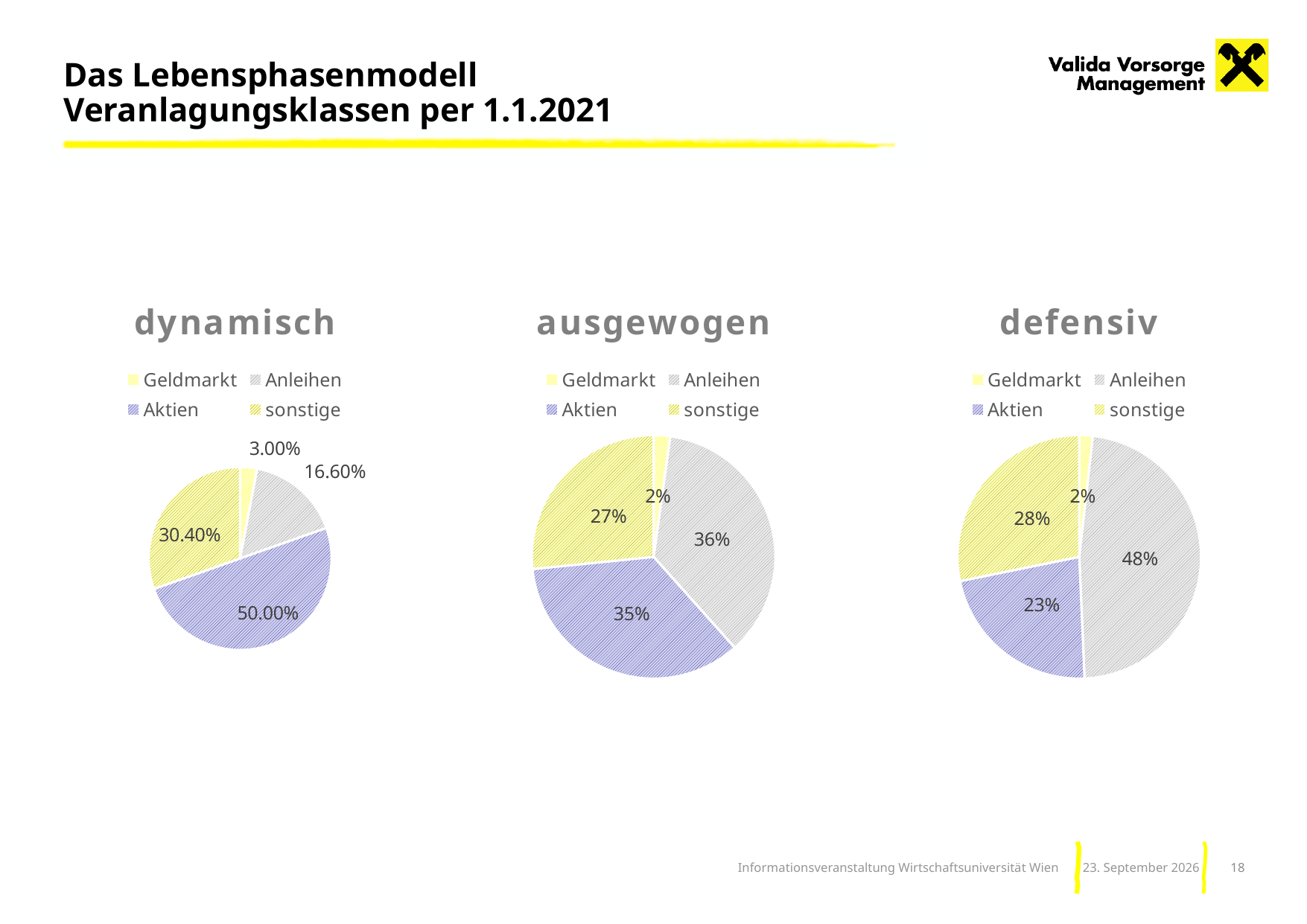
In the 'defensiv' pie chart, which category has the largest share? Anleihen In the 'defensiv' pie chart, what share is shown for Anleihen? 48% In the 'ausgewogen' pie chart, what share is shown for sonstige? 27% In the 'dynamisch' pie chart, which category has the smallest share? Geldmarkt In the 'dynamisch' pie chart, what is the difference between the shares of Aktien and sonstige? 19.60% How many categories does the legend of the 'ausgewogen' chart list? 4 In the 'dynamisch' pie chart, what share is shown for Anleihen? 16.60% In the 'ausgewogen' pie chart, what is the difference between the shares of Anleihen and Geldmarkt? 34% In the 'defensiv' pie chart, which is larger: the share of Aktien or the share of sonstige? sonstige What kind of chart is used for 'defensiv'? Pie chart In the 'dynamisch' pie chart, what share is shown for Aktien? 50.00% How many pie charts are shown on the slide? 3